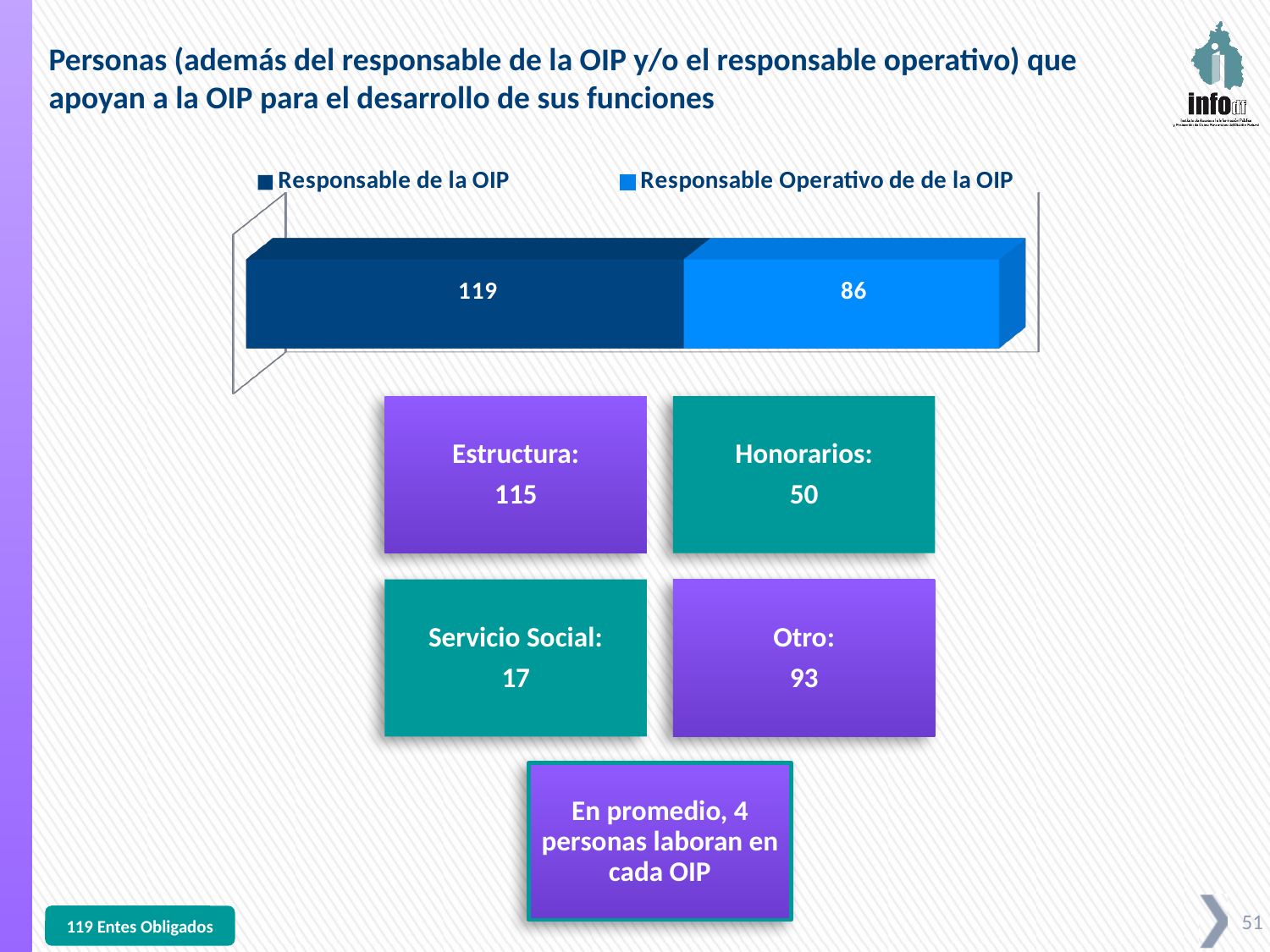
What kind of chart is shown on the slide? Stacked bar chart What colour is used for the Responsable Operativo de de la OIP series in the bar chart? Light blue How many series does the legend of the bar chart list? 2 How many bars are plotted in the chart? 1 What value is shown for the Responsable de la OIP series in the bar chart? 119 Which series has the larger value in the bar chart, Responsable de la OIP or Responsable Operativo de de la OIP? Responsable de la OIP Which series has the smallest value in the bar chart? Responsable Operativo de de la OIP What value is shown for the Responsable Operativo de de la OIP series in the bar chart? 86 What is the first legend entry of the bar chart? Responsable de la OIP Which series has the largest value in the bar chart? Responsable de la OIP What is the difference between the Responsable de la OIP value and the Responsable Operativo de de la OIP value in the bar chart? 33 What is the total of the stacked bar in the chart? 205